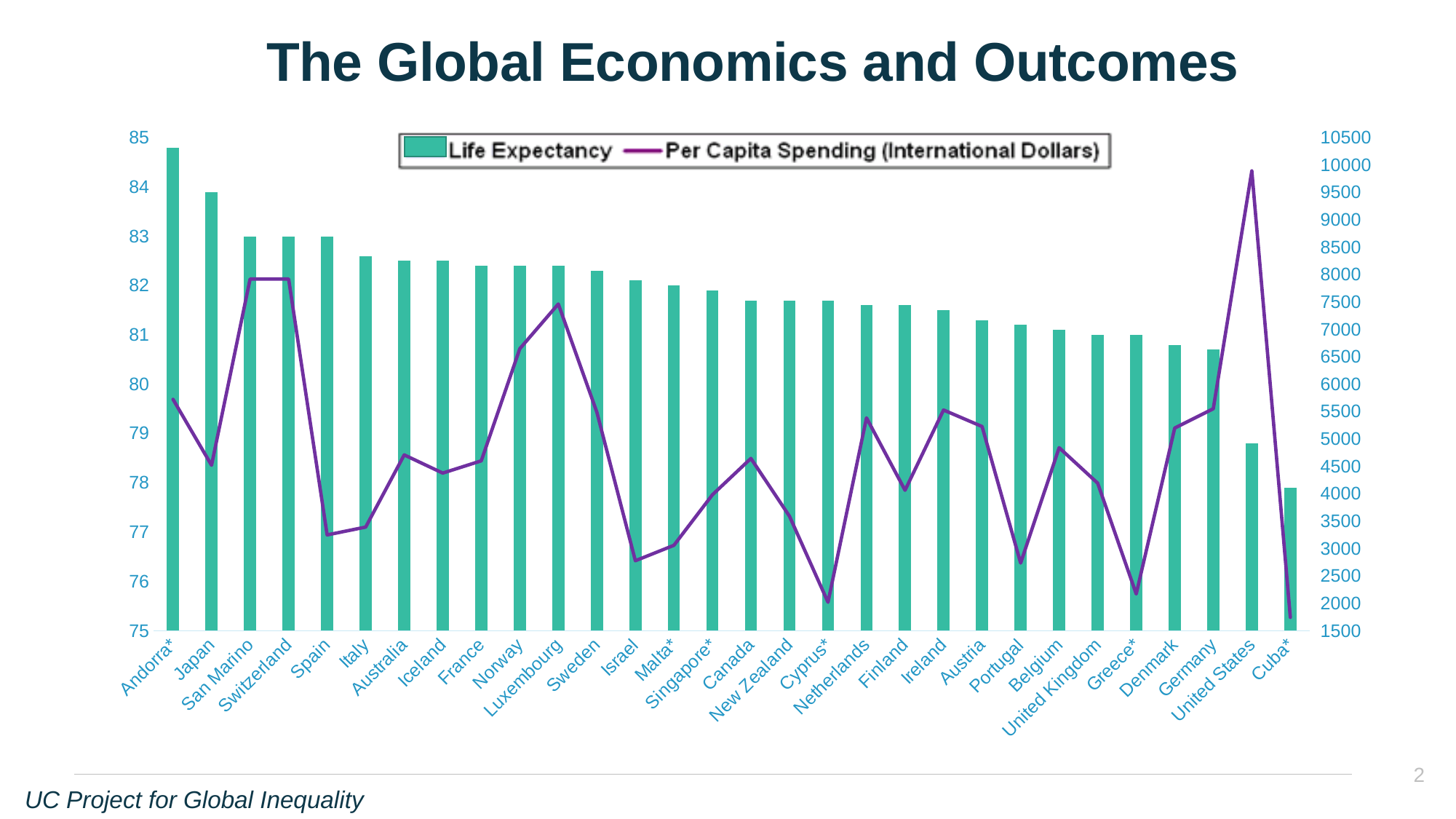
Is the Per Capita Spending for the United States greater or less than 9000? greater Which country has the highest Per Capita Spending? United States Do the Life Expectancy bars generally rise or fall from left to right along the x axis? fall What kind of chart is shown on the slide? Combined bar and line chart Is the Per Capita Spending for Cyprus* greater or less than 2500? less How many countries are shown on the x axis? 30 Which country has the lowest Per Capita Spending? Cuba* How many series does the legend list? 2 Which country has the highest Life Expectancy? Andorra* Which country has the lowest Life Expectancy? Cuba* Which has the higher Per Capita Spending, Luxembourg or Spain? Luxembourg What is the Life Expectancy for Spain? 83